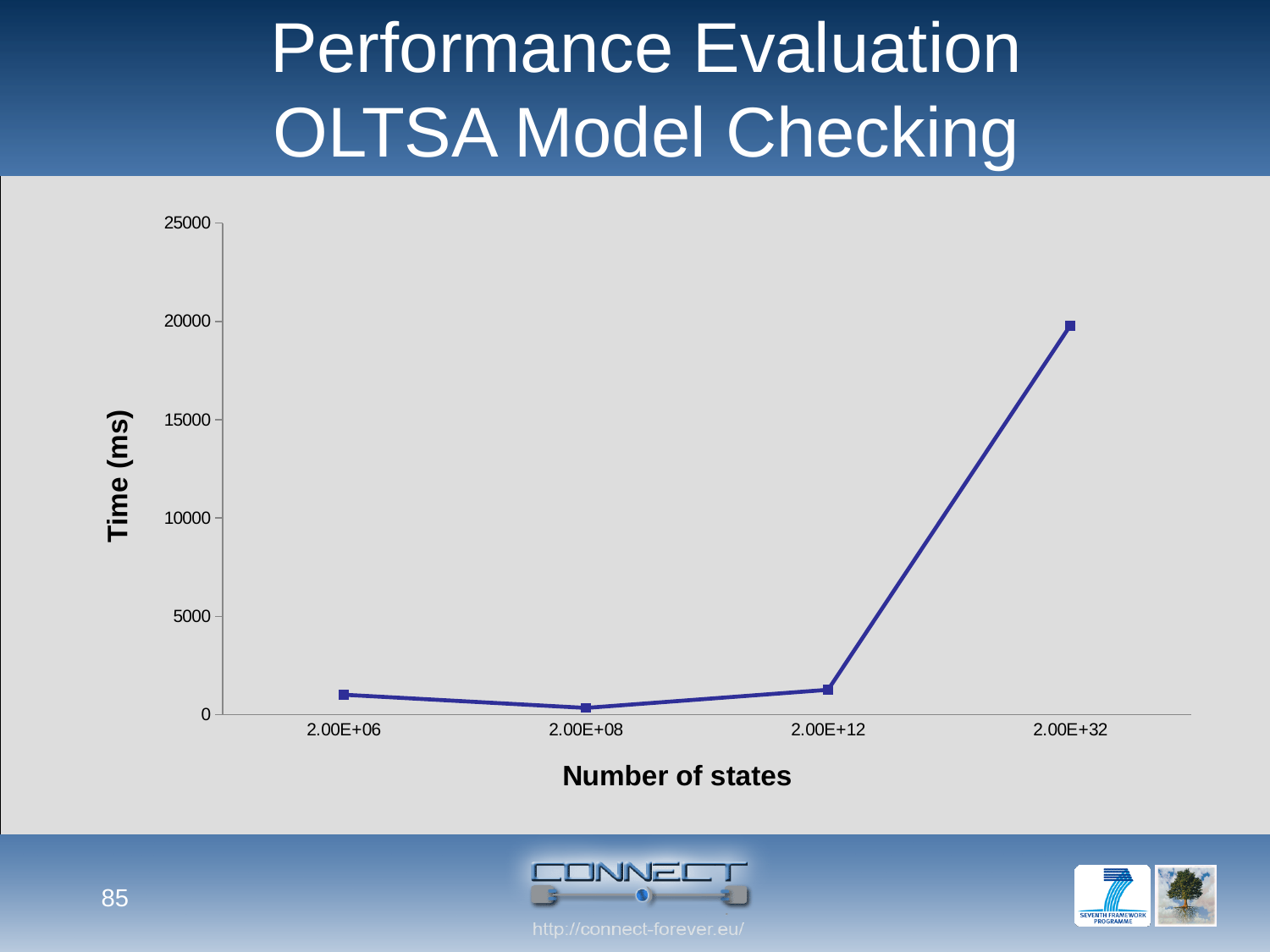
Is the time for 2.00E+06 states greater or less than 5000 ms? less What is the label of the x axis? Number of states Between 2.00E+12 and 2.00E+32 states, does the line rise or fall? rise What is the label of the y axis? Time (ms) Which number of states has the lowest time? 2.00E+08 Which has a larger time: 2.00E+06 states or 2.00E+08 states? 2.00E+06 What kind of chart is shown on the slide? line chart Is the time for 2.00E+12 states greater or less than 5000 ms? less Is the time for 2.00E+32 states greater or less than 15000 ms? greater Which number of states has the highest time? 2.00E+32 How many data points are plotted on the line? 4